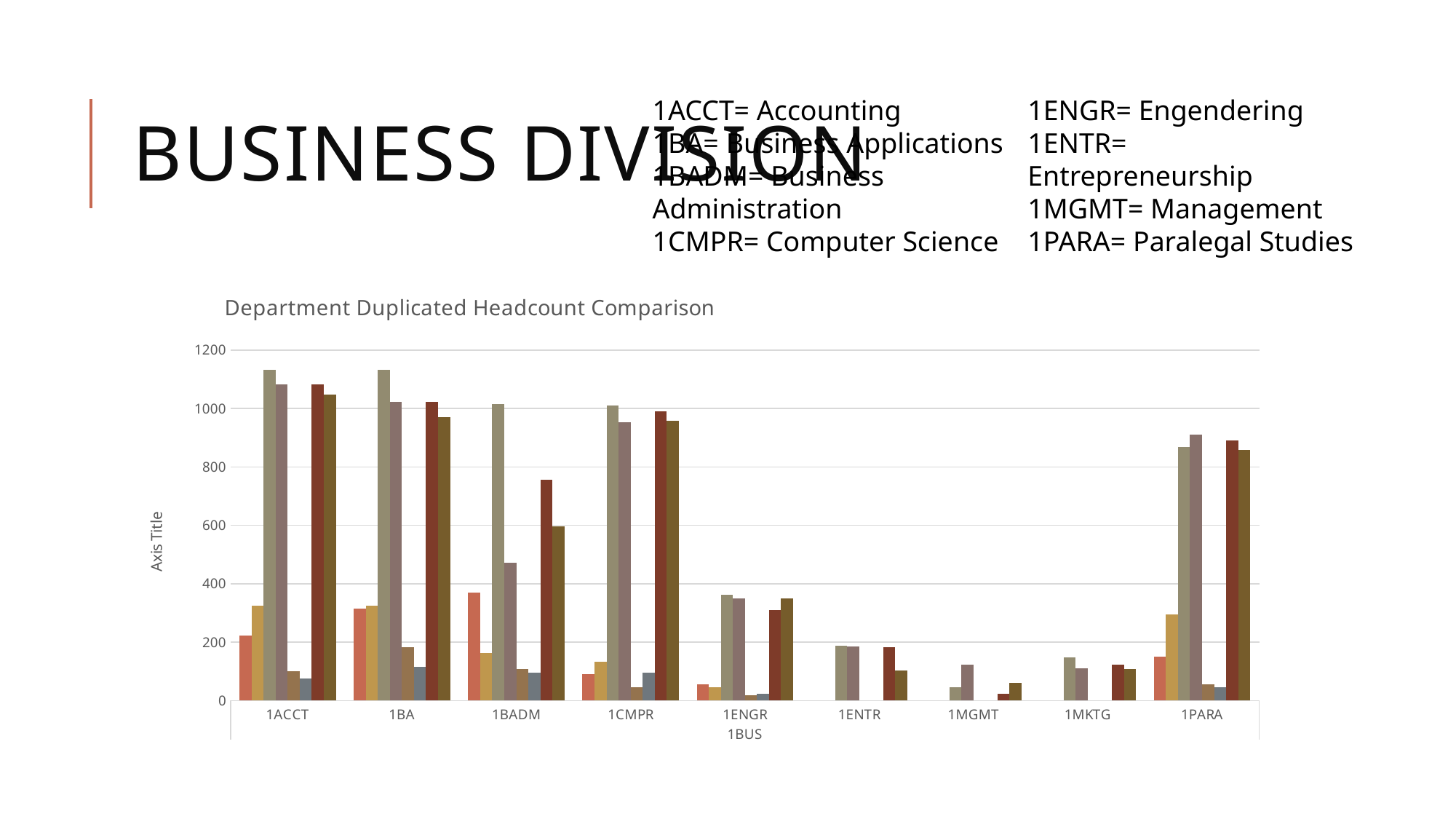
What kind of chart is shown on the slide? bar chart Which category has the taller tallest bar, 1PARA or 1ENGR? 1PARA What label is shown on the vertical axis of the chart? Axis Title Which category has the taller tallest bar, 1CMPR or 1MKTG? 1CMPR Is the tallest bar for 1ACCT greater or less than 1000? greater Is the tallest bar for 1PARA greater or less than 800? greater Which category has the taller tallest bar, 1ACCT or 1MGMT? 1ACCT Is the tallest bar for 1ENGR greater or less than 400? less What is the title of the chart? Department Duplicated Headcount Comparison How many categories are shown along the x axis of the chart? 9